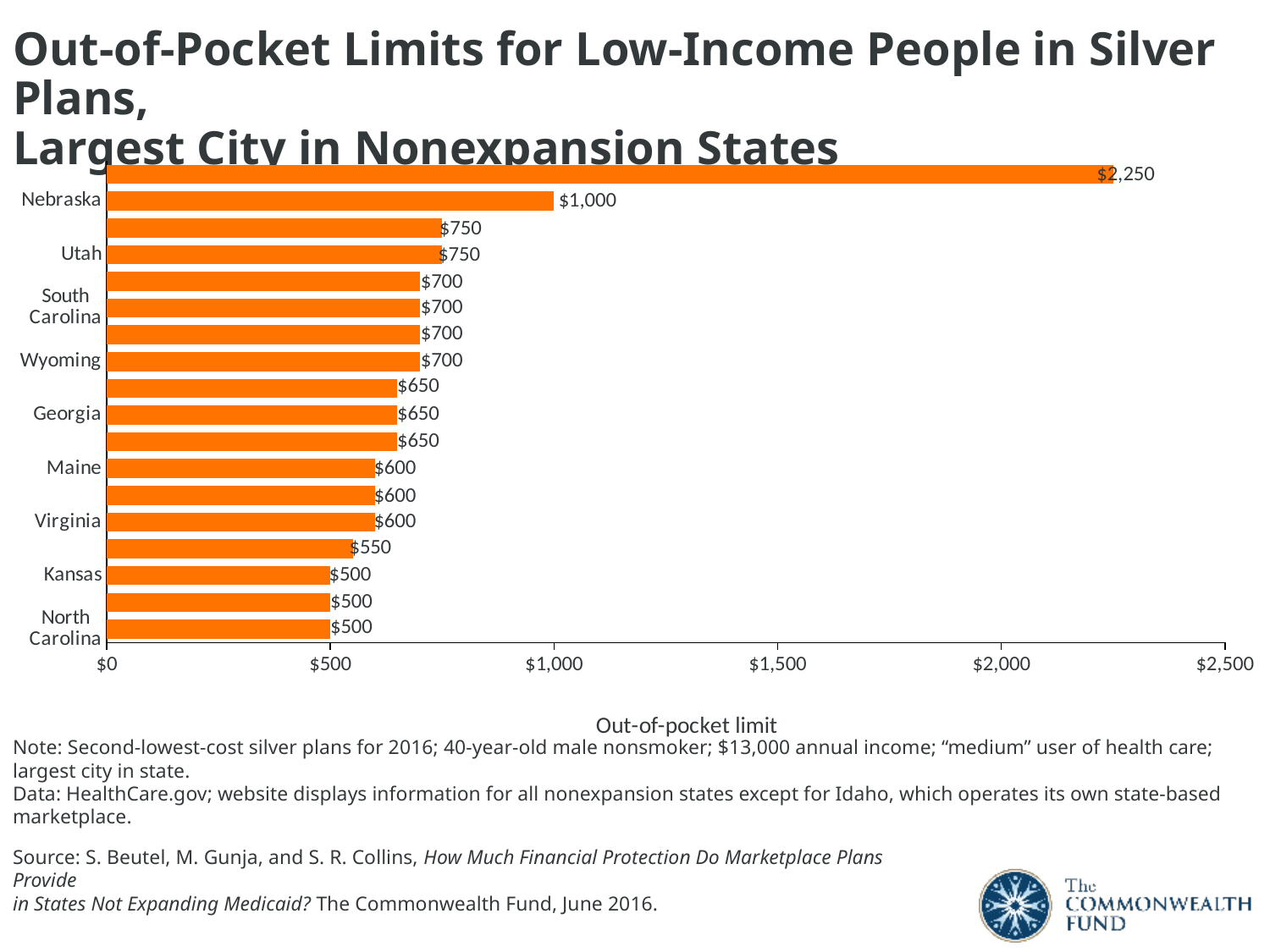
How many bars are plotted in the chart? 18 What is the out-of-pocket limit shown for South Carolina? $700 What is the out-of-pocket limit shown for Georgia? $650 What is the out-of-pocket limit shown for Nebraska? $1,000 What is the title of the horizontal axis? Out-of-pocket limit What is the out-of-pocket limit shown for Virginia? $600 What is the out-of-pocket limit shown for North Carolina? $500 Which has a higher out-of-pocket limit, Nebraska or Wyoming? Nebraska What is the out-of-pocket limit shown for Utah? $750 Is the out-of-pocket limit for Maine greater or less than $1,000? less What kind of chart is shown on the slide? Bar chart What is the difference between the out-of-pocket limits for Nebraska and Utah? $250